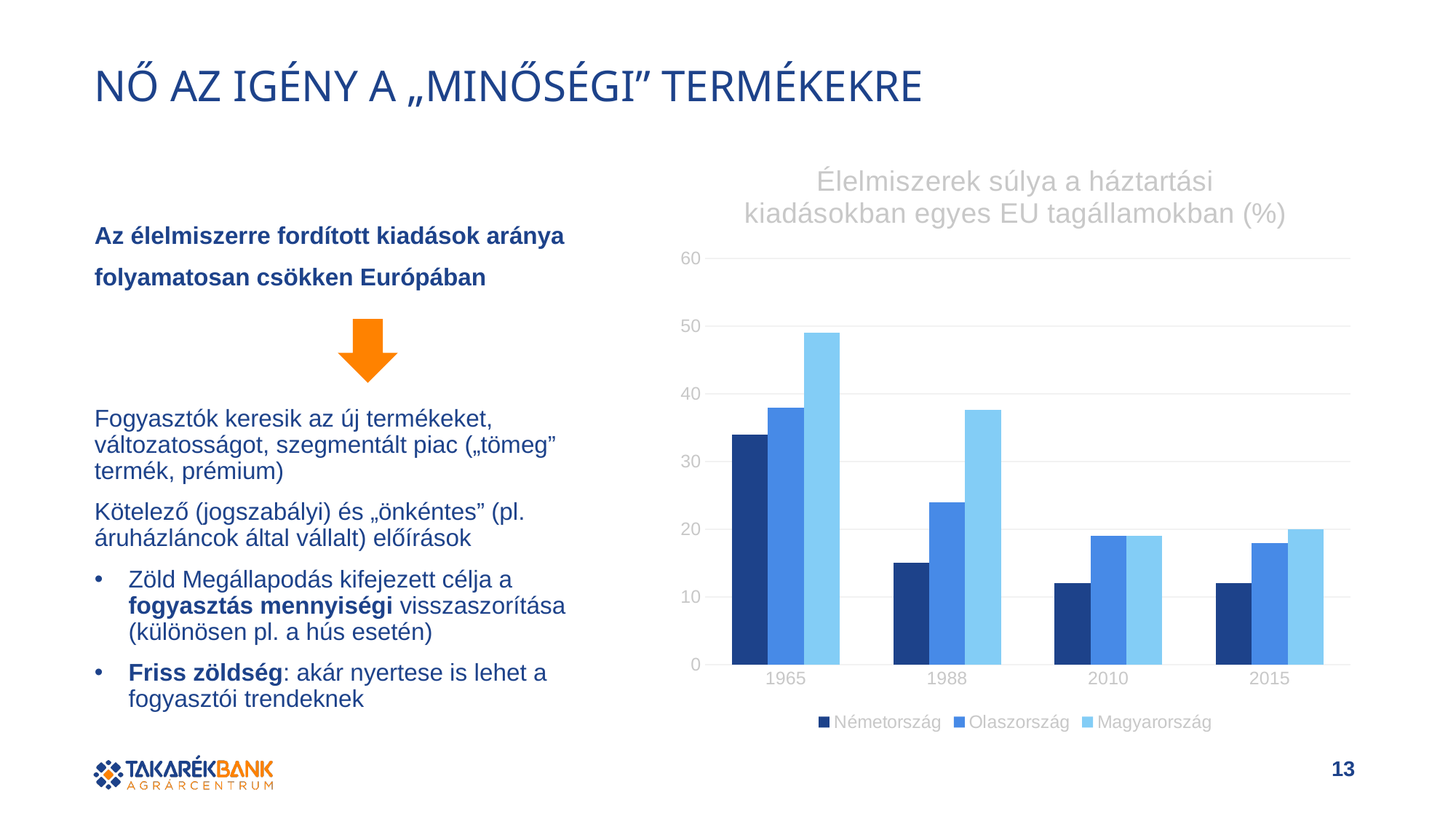
Which is larger in 1988, the value for Olaszország or the value for Németország? Olaszország Is the value for Magyarország in 1965 greater or less than 40? greater Is the value for Olaszország in 1988 greater or less than 20? greater Is the value for Németország in 2010 greater or less than 20? less Do the values for Németország rise or fall from 1965 to 2015? fall What kind of chart is shown on the slide? bar chart Which series has the highest value in 1965? Magyarország Which series has the lowest value in 1988? Németország How many series does the legend list? 3 How many year categories are shown on the x axis? 4 What is the title of the chart? Élelmiszerek súlya a háztartási kiadásokban egyes EU tagállamokban (%)